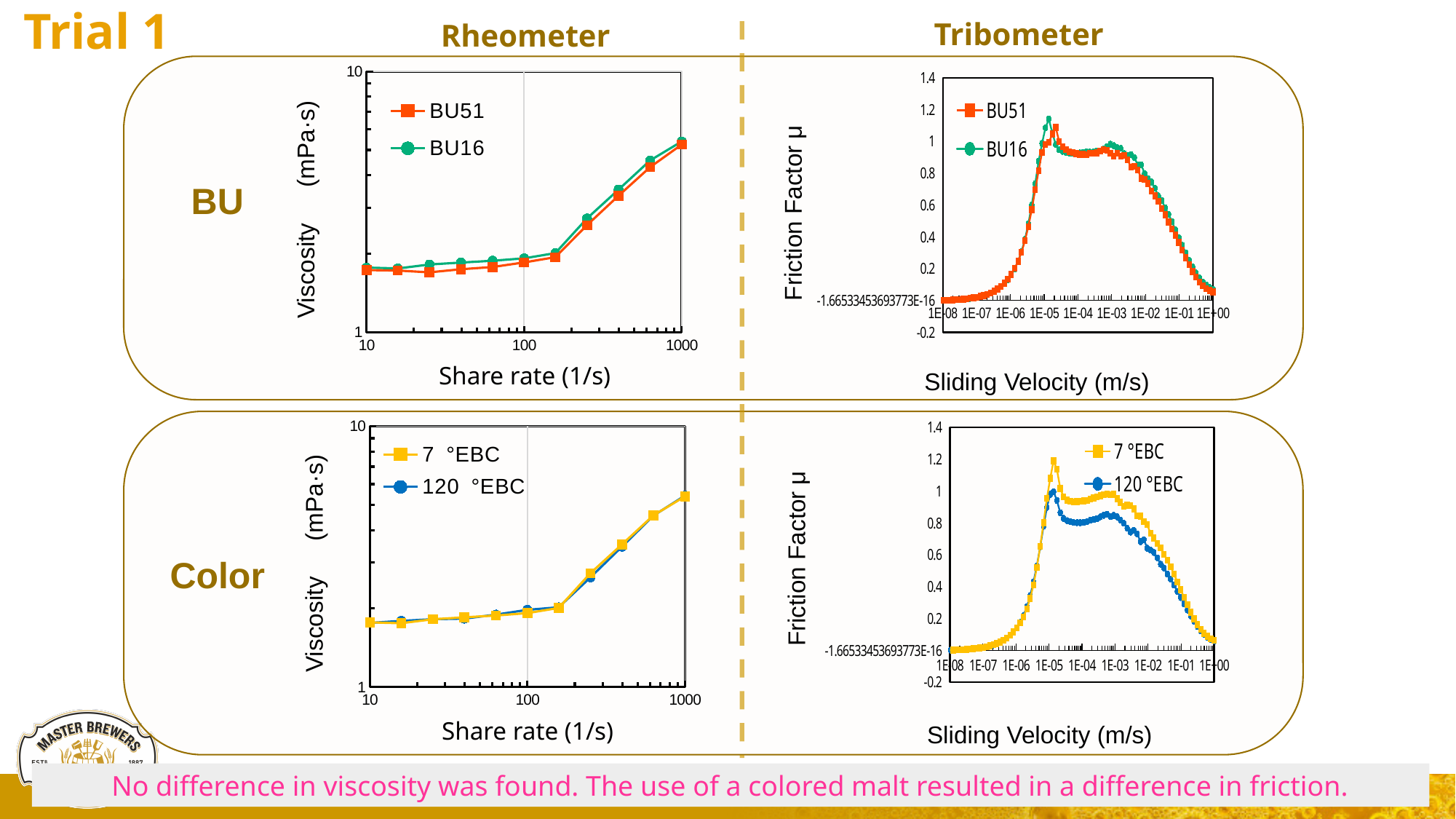
In the Color Tribometer chart (bottom right), is the peak friction factor for 120 °EBC greater or less than 1.2? less In the BU Rheometer chart (top left), how many series does the legend list? 2 In the Color Tribometer chart (bottom right), which series reaches the higher peak friction factor? 7 °EBC In the Color Rheometer chart (bottom left), what are the two legend entries? 7 °EBC and 120 °EBC In the Color Tribometer chart (bottom right), does the friction factor rise or fall as sliding velocity increases from 1E-02 to 1E+00 m/s? fall What is the x-axis label of the BU Tribometer chart (top right)? Sliding Velocity (m/s) In the Color Tribometer chart (bottom right), is the peak friction factor for 7 °EBC greater or less than 1? greater In the Color Tribometer chart (bottom right), at a sliding velocity of about 1E-03 m/s, which series has the higher friction factor, 7 °EBC or 120 °EBC? 7 °EBC What kind of chart is the BU Rheometer chart (top left)? line chart In the BU Tribometer chart (top right), how many series does the legend list? 2 In the BU Rheometer chart (top left), does viscosity rise or fall as share rate increases from 100 to 1000 1/s? rise In the Color Rheometer chart (bottom left), is the viscosity at a share rate of 1000 1/s greater or less than 10 mPa·s? less